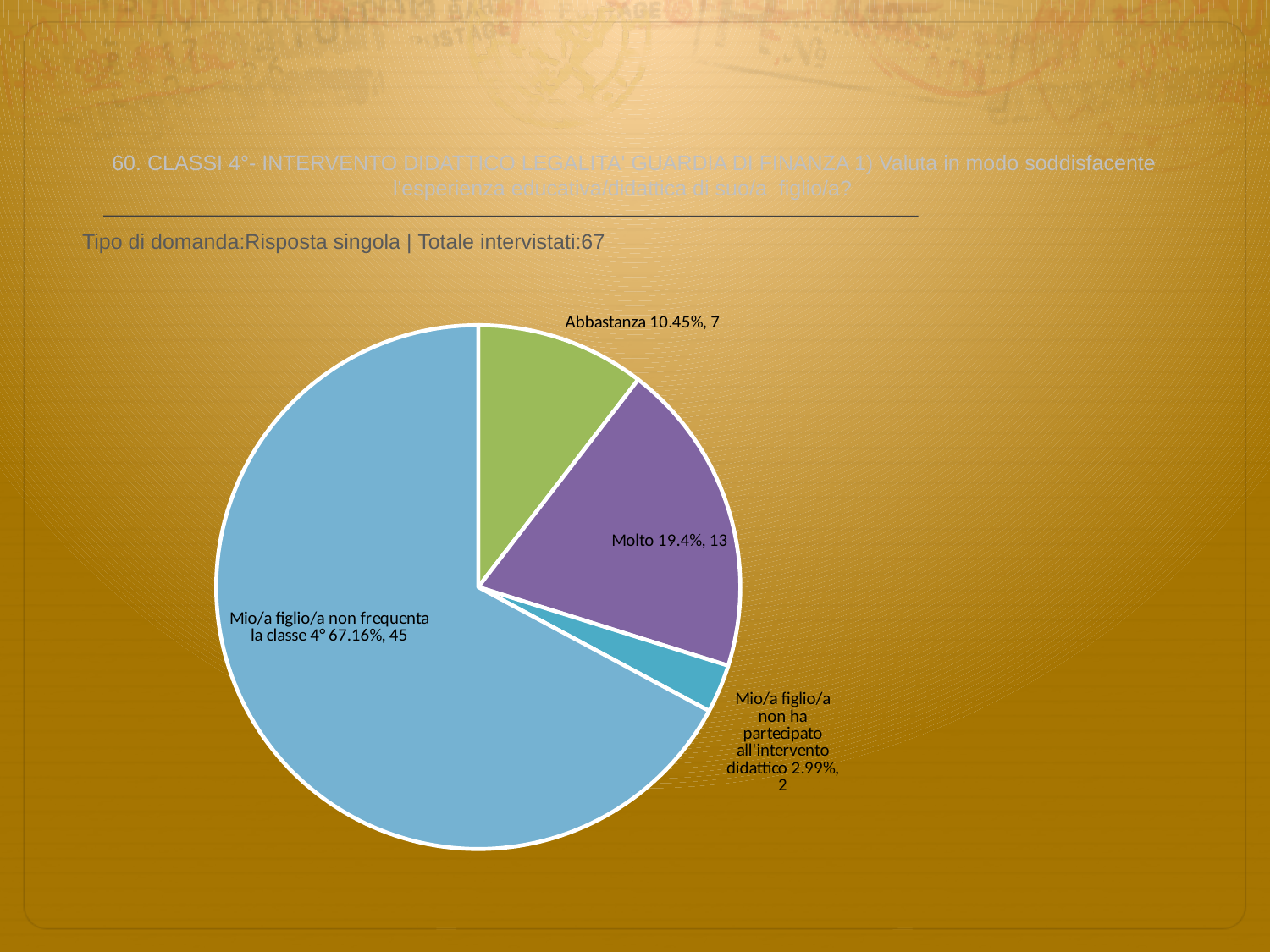
Which has more respondents, "Molto" or "Abbastanza"? Molto What is the difference in respondent count between "Molto" and "Abbastanza"? 6 Which category has the smallest slice of the pie? Mio/a figlio/a non ha partecipato all'intervento didattico How many slices does the pie chart have? 4 How many respondents answered "Mio/a figlio/a non frequenta la classe 4°"? 45 What percentage share does the "Mio/a figlio/a non ha partecipato all'intervento didattico" slice represent? 2.99% Which category has the largest slice of the pie? Mio/a figlio/a non frequenta la classe 4° What percentage share does the "Abbastanza" slice represent? 10.45% How many respondents answered "Abbastanza"? 7 What is the total number of respondents (Totale intervistati) stated on the slide? 67 What percentage share does the "Molto" slice represent? 19.4% What kind of chart is shown on the slide? Pie chart